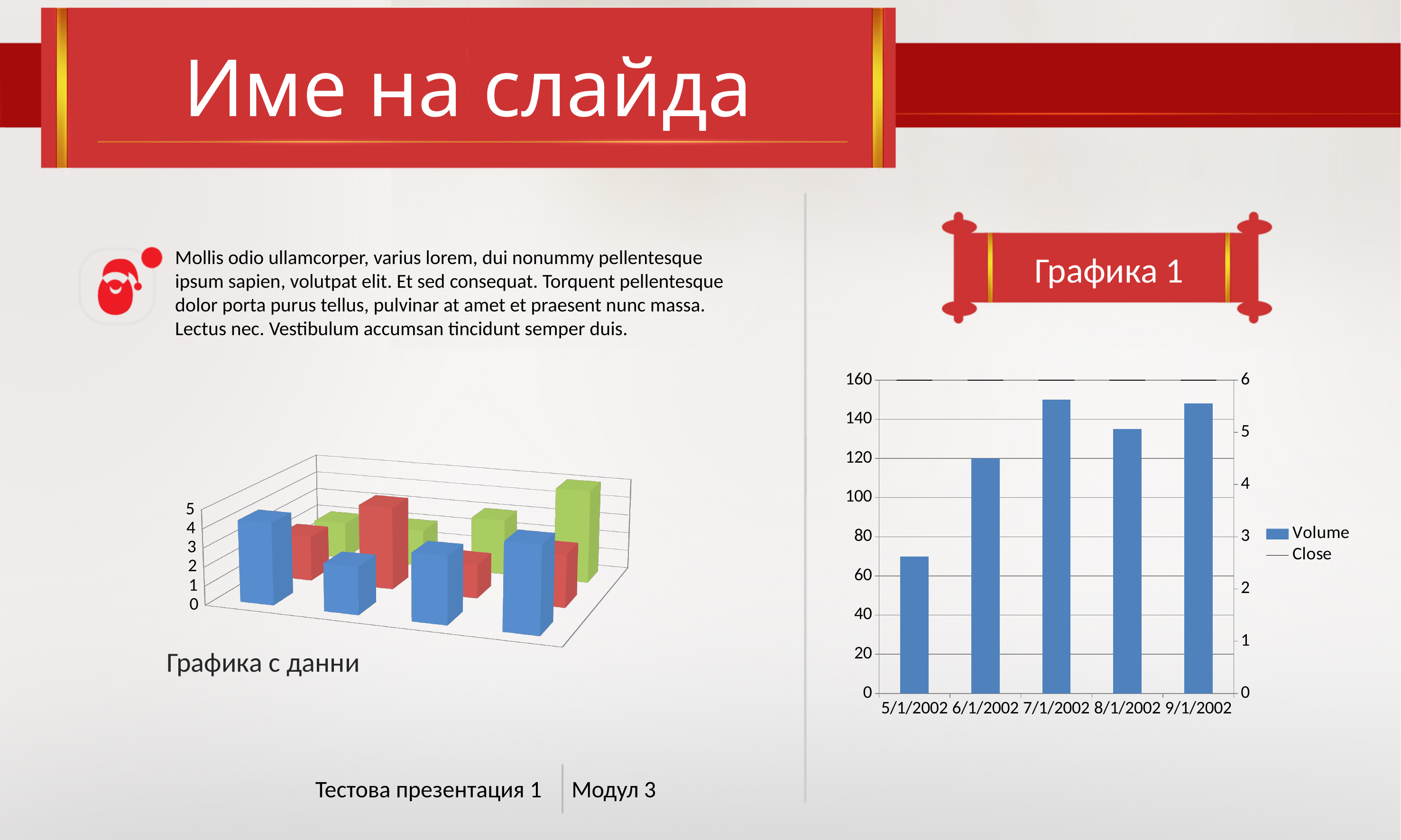
In the chart titled "Графика 1", is the Volume value for 7/1/2002 greater or less than 140? greater In the chart titled "Графика 1", how many series does the legend list? 2 In the chart titled "Графика 1", what are the two entries in the legend? Volume and Close In the chart titled "Графика 1", is the Volume value for 8/1/2002 greater or less than 120? greater What kind of chart is the chart titled "Графика 1" on the right of the slide? bar chart What kind of chart is the chart titled "Графика с данни" on the left of the slide? bar chart In the chart titled "Графика с данни", what is the highest value shown on the vertical axis? 5 In the chart titled "Графика 1", which has the larger Volume bar, 6/1/2002 or 8/1/2002? 8/1/2002 In the chart titled "Графика 1", is the Volume value for 6/1/2002 greater or less than 100? greater In the chart titled "Графика 1", how many dates are shown on the x axis? 5 In the chart titled "Графика 1", which date has the lowest Volume bar? 5/1/2002